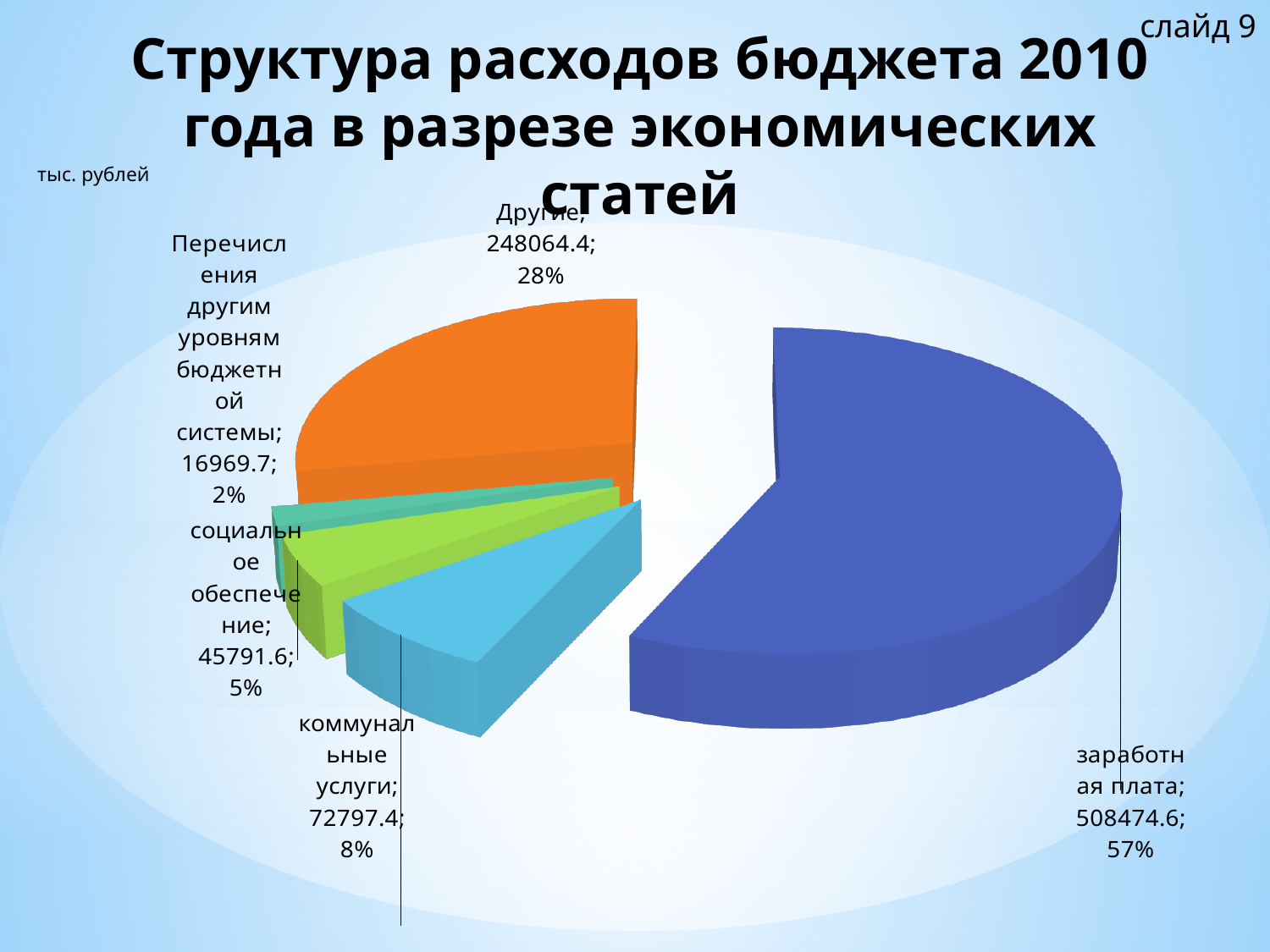
What is the value for коммунальные услуги? 72797.4 What kind of chart is shown on the slide? pie chart Which category has the smallest slice? Перечисления другим уровням бюджетной системы What share of the pie does Перечисления другим уровням бюджетной системы take? 2% How many slices does the pie chart have? 5 What is the value for заработная плата? 508474.6 What share of the pie does заработная плата take? 57% What unit is indicated for the values on the chart? тыс. рублей Which category has the largest slice? заработная плата What is the value for социальное обеспечение? 45791.6 Which is larger, коммунальные услуги or социальное обеспечение? коммунальные услуги What is the value for Другие? 248064.4